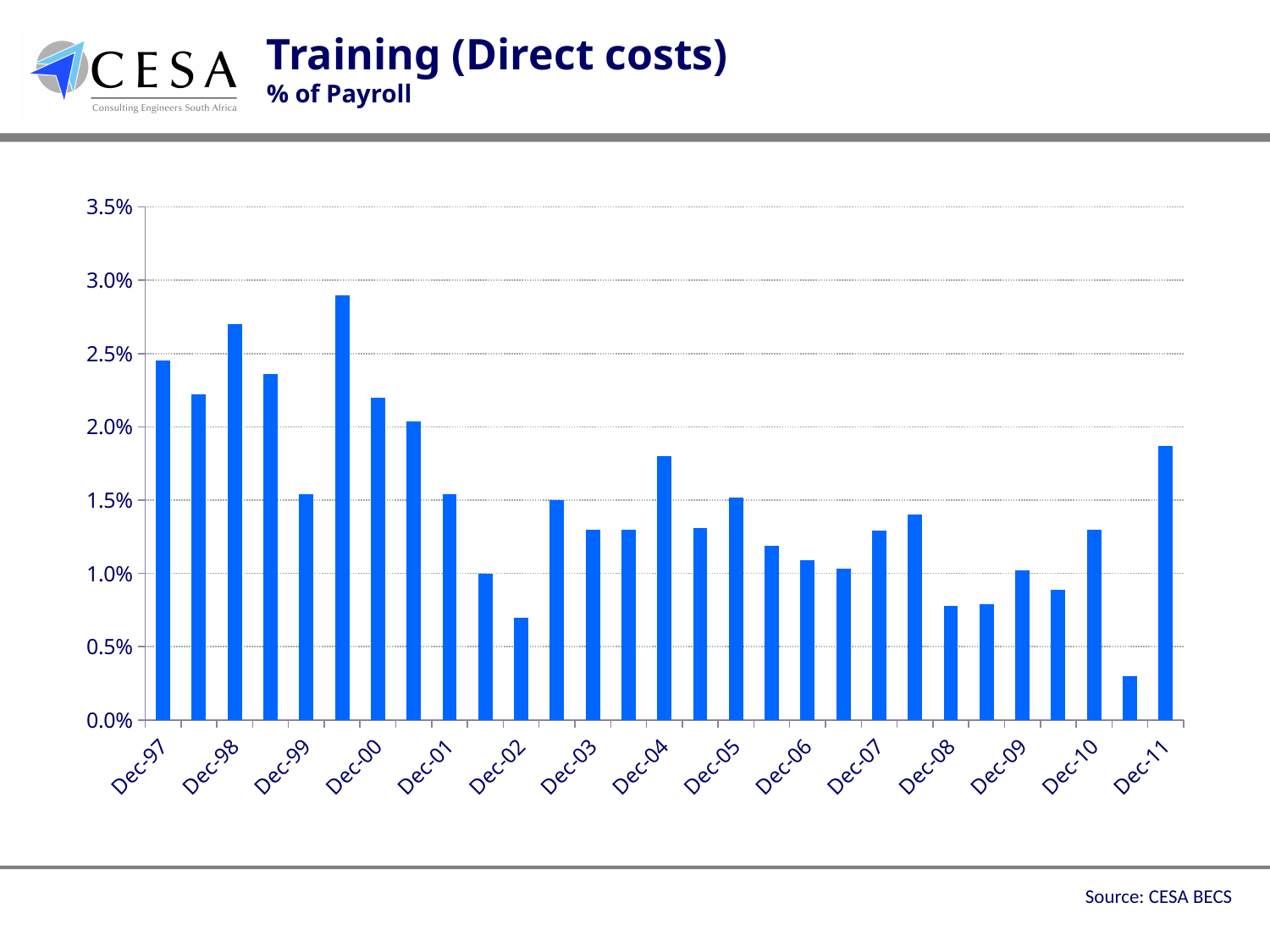
Is the value for Dec-98 greater or less than 2.5%? greater Is the value for Dec-11 greater or less than 2.0%? less Is the value for Dec-97 greater or less than 2.0%? greater How many date labels are shown on the x axis? 15 Which is larger, the value for Dec-02 or the value for Dec-04? Dec-04 Do the values generally rise or fall from Dec-97 to Dec-09? Fall What source is cited for the chart? CESA BECS What kind of chart is shown on the slide? Bar chart Which is larger, the value for Dec-98 or the value for Dec-11? Dec-98 What is the title of the chart on the slide? Training (Direct costs) % of Payroll